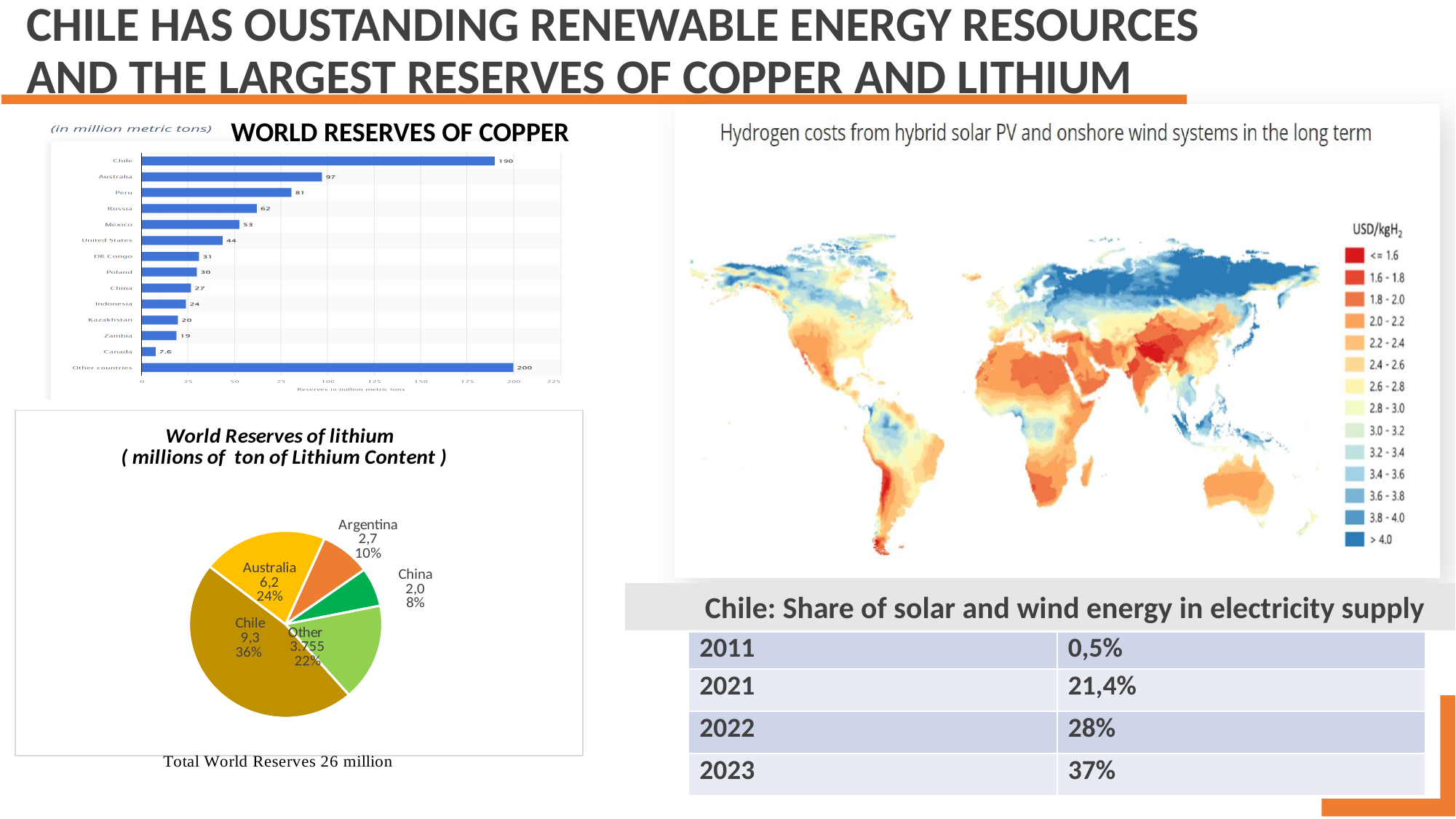
What kind of chart is the World Reserves of Copper chart? Bar chart In the World Reserves of lithium pie chart, what percentage share does Australia have? 24% How many bars are shown in the World Reserves of Copper chart? 14 How many slices does the World Reserves of lithium pie chart have? 5 In the World Reserves of Copper chart, what is the value for Peru? 81 In the World Reserves of lithium pie chart, what is the value shown for Chile? 9,3 In the World Reserves of lithium pie chart, which slice is the smallest? China In the World Reserves of Copper chart, which category has the lowest value? Canada In the World Reserves of Copper chart, which is larger, the value for Russia or the value for Mexico? Russia In the World Reserves of Copper chart, what is the difference between the values for Chile and Australia? 93 In the World Reserves of Copper chart, which category has the longest bar? Other countries In the World Reserves of Copper chart, what is the value for Chile? 190